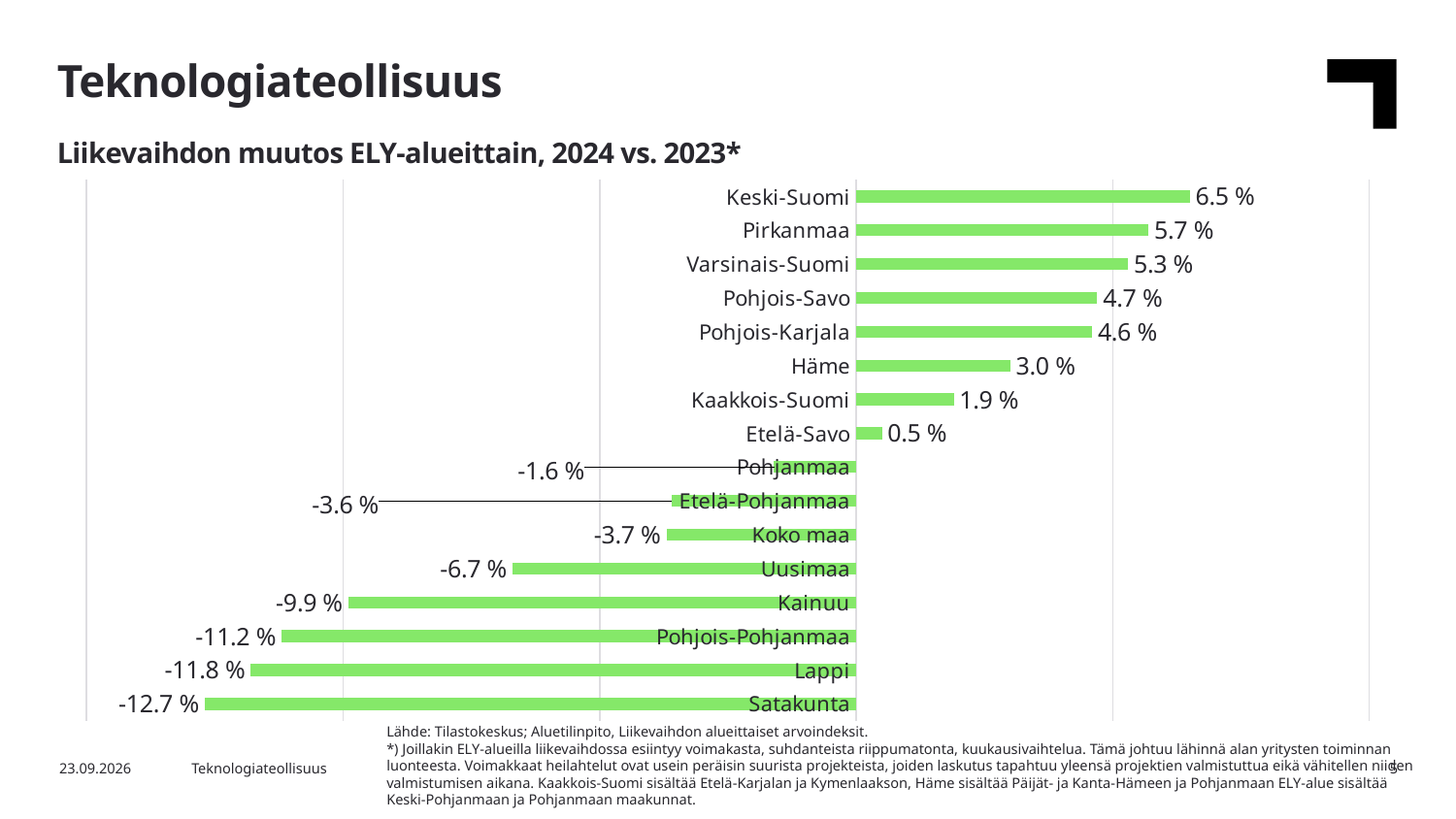
What is the value for Keski-Suomi? 6.5 % How many ELY areas (categories) are shown in the chart? 16 What is the difference between the values for Lappi and Satakunta? 0.9 % What is the value for Häme? 3.0 % Which ELY area has the lowest value? Satakunta What is the value for Koko maa? -3.7 % What kind of chart is shown on the slide? Bar chart What is the value for Uusimaa? -6.7 % What is the difference between the values for Keski-Suomi and Pirkanmaa? 0.8 % What is the title of the chart? Liikevaihdon muutos ELY-alueittain, 2024 vs. 2023* Which ELY area has the highest value? Keski-Suomi Which has a larger value, Pohjois-Savo or Kaakkois-Suomi? Pohjois-Savo